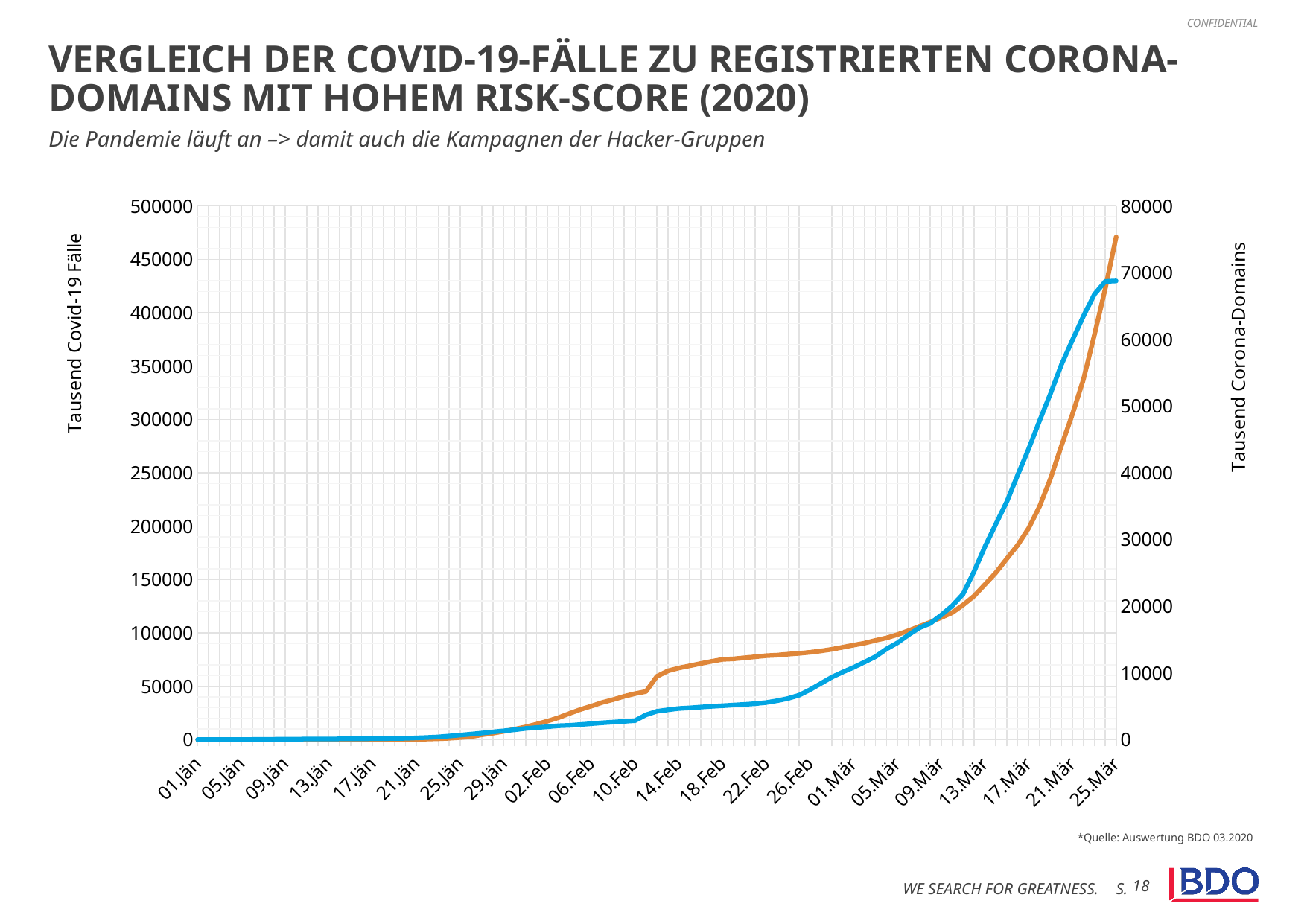
How many date labels are shown on the x axis? 22 Do the values of the blue line rise or fall from 01.Jän to 25.Mär? rise Do the values of the orange line rise or fall from 01.Jän to 25.Mär? rise What is the title of the right vertical axis? Tausend Corona-Domains What is the highest tick value shown on the left vertical axis? 500000 What kind of chart is shown on the slide? line chart What is the title of the left vertical axis? Tausend Covid-19 Fälle How many lines are plotted on the chart? 2